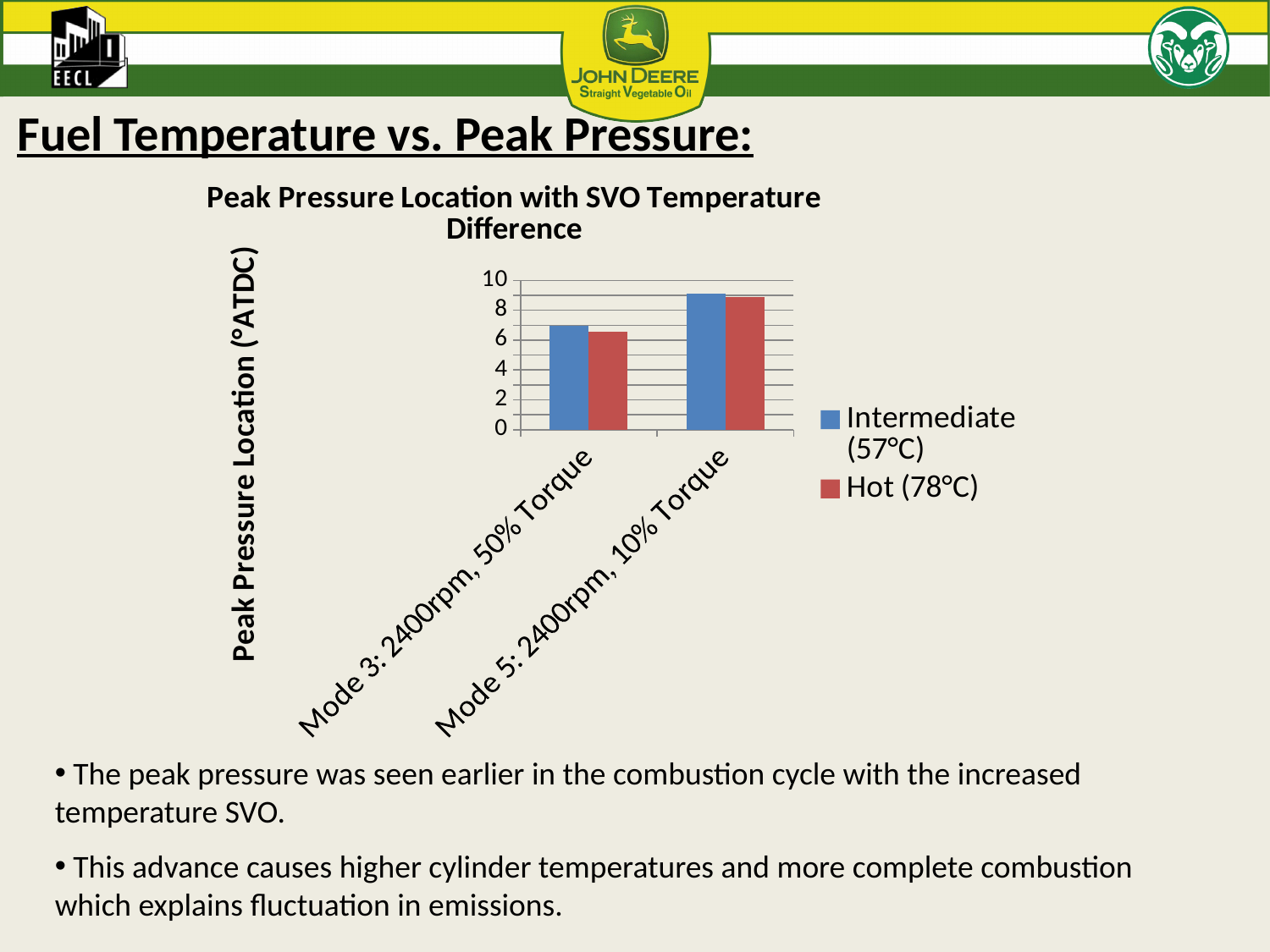
Is the Hot (78°C) value for Mode 3: 2400rpm, 50% Torque greater or less than 8? less What is the label of the y axis of the chart? Peak Pressure Location (°ATDC) How many categories are shown on the x axis of the chart? 2 What kind of chart is shown on the slide? Bar chart Is the Intermediate (57°C) value for Mode 3: 2400rpm, 50% Torque greater or less than 8? less Is the Intermediate (57°C) value for Mode 5: 2400rpm, 10% Torque greater or less than 8? greater For the Intermediate (57°C) series, which category has the larger value: Mode 3: 2400rpm, 50% Torque or Mode 5: 2400rpm, 10% Torque? Mode 5: 2400rpm, 10% Torque Do the Hot (78°C) values rise or fall from Mode 3: 2400rpm, 50% Torque to Mode 5: 2400rpm, 10% Torque? rise What is the title of the chart? Peak Pressure Location with SVO Temperature Difference How many series does the chart legend list? 2